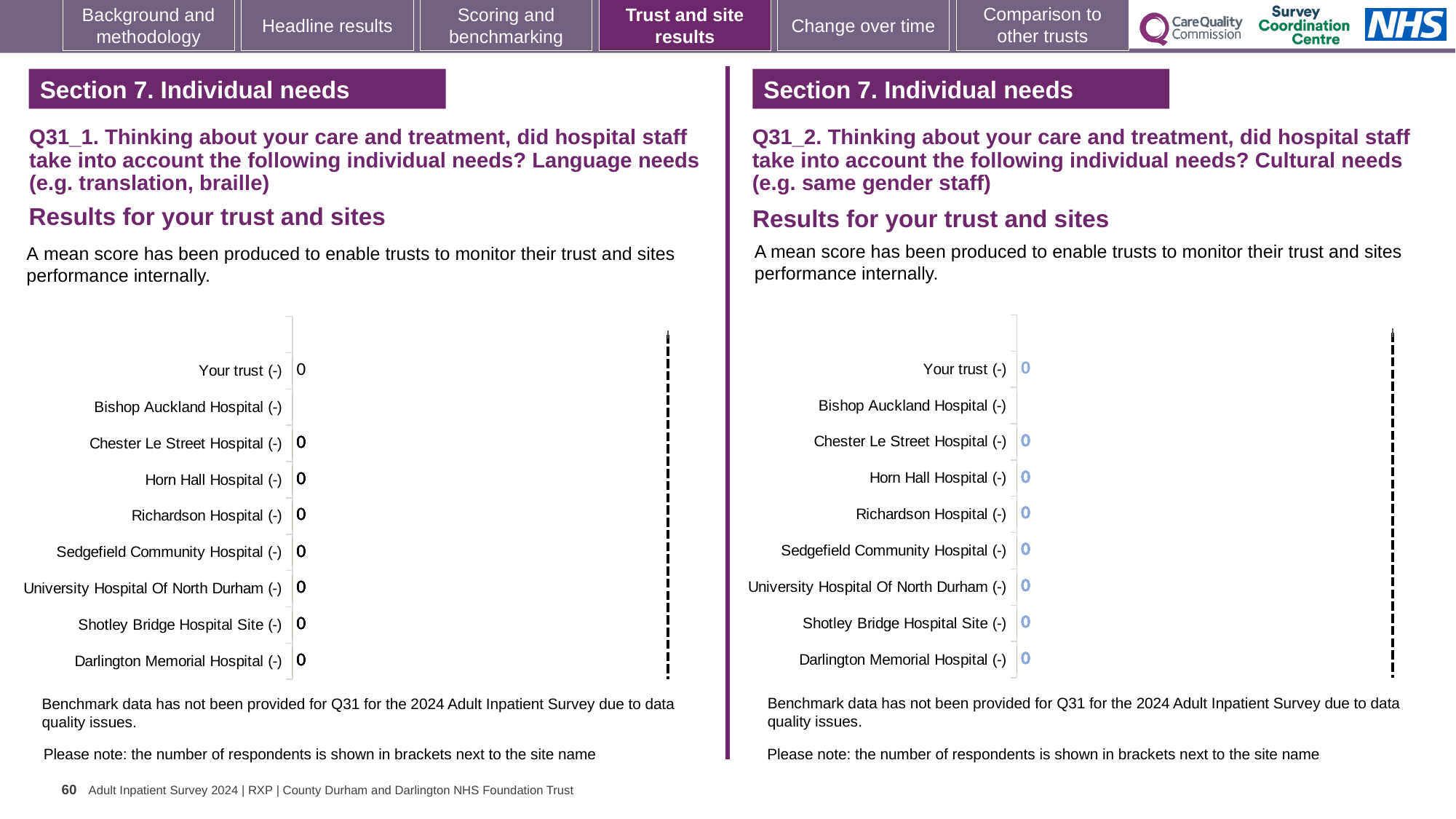
In the left chart (Q31_1, Language needs), what is the value shown for Darlington Memorial Hospital? 0 What kind of chart is used on the left side of the slide for Q31_1? Bar chart In the right chart (Q31_2, Cultural needs), what is the value shown for Shotley Bridge Hospital Site? 0 Which question does the right chart on the slide relate to? Q31_2. Thinking about your care and treatment, did hospital staff take into account the following individual needs? Cultural needs (e.g. same gender staff) In the left chart (Q31_1, Language needs), what is the difference between the values for Your trust and Horn Hall Hospital? 0 In the right chart (Q31_2, Cultural needs), what is the value shown for Sedgefield Community Hospital? 0 In the left chart (Q31_1, Language needs), what is the value shown for University Hospital Of North Durham? 0 Which category in the right chart (Q31_2, Cultural needs) has no data label shown next to it? Bishop Auckland Hospital (-) In the left chart (Q31_1, Language needs), what is the value shown for Your trust? 0 How many categories (trust and sites) are listed on the left chart (Q31_1, Language needs)? 9 In the right chart (Q31_2, Cultural needs), what is the value shown for Your trust? 0 How many categories (trust and sites) are listed on the right chart (Q31_2, Cultural needs)? 9